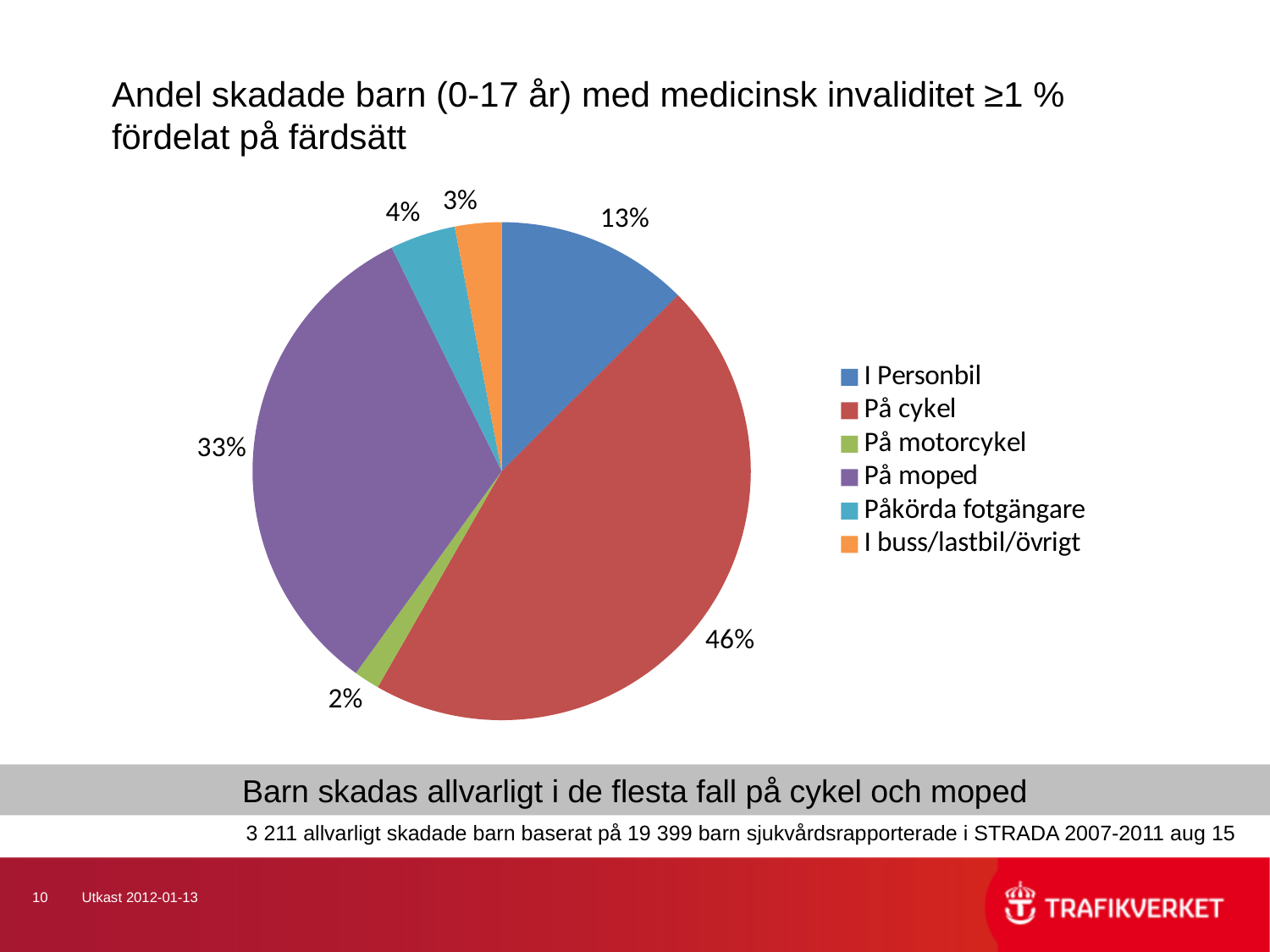
What is the difference in percentage points between "På cykel" and "På moped"? 13 What kind of chart is shown on the slide? pie chart Which category has the smallest slice of the pie? På motorcykel What share of the pie does "På moped" have? 33% Which category has the largest slice of the pie? På cykel What share of the pie does "Påkörda fotgängare" have? 4% What share of the pie does "På cykel" have? 46% How many categories does the legend list? 6 Which is larger, the share for "I Personbil" or the share for "Påkörda fotgängare"? I Personbil